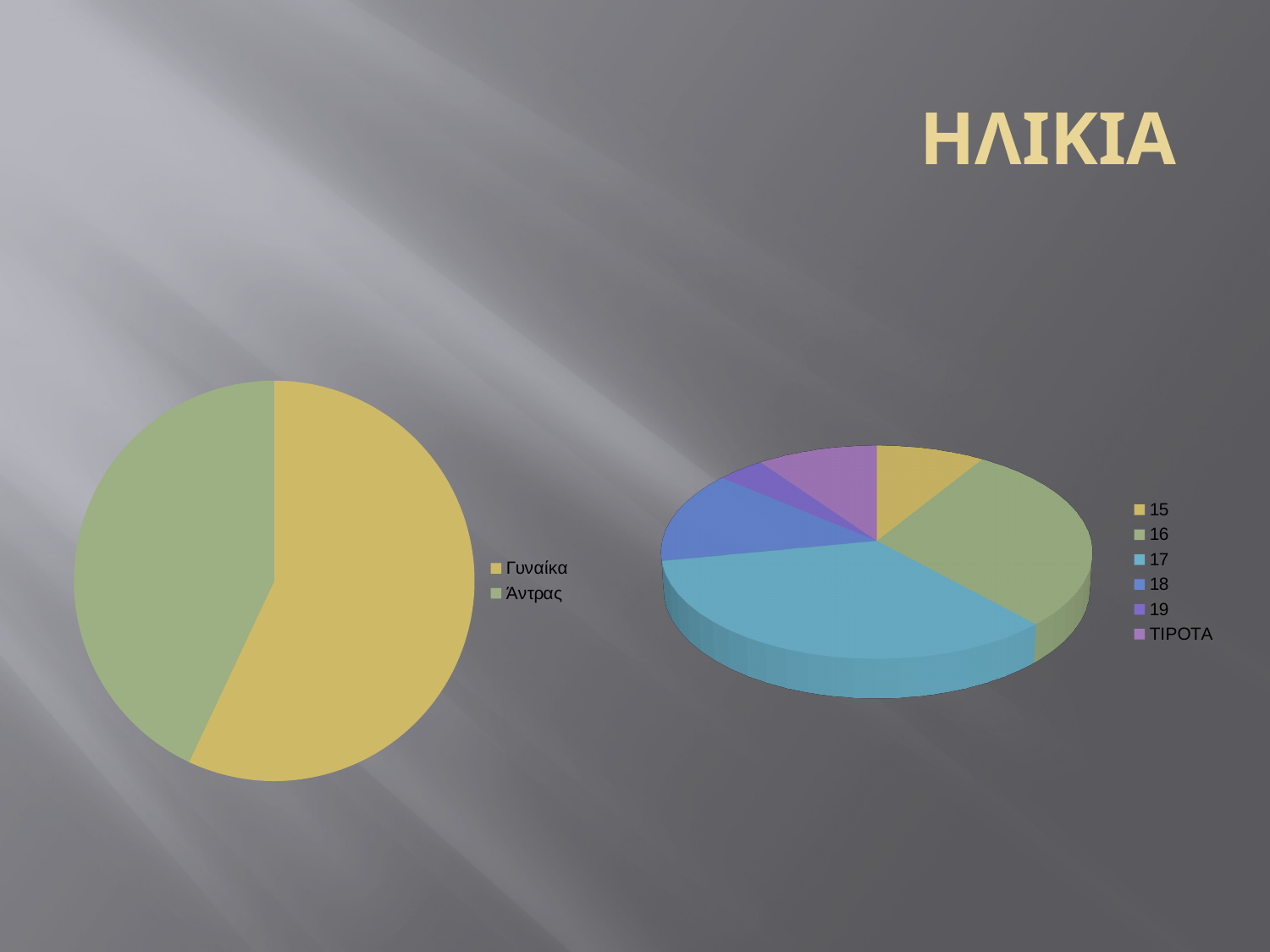
In the right pie chart, which category has the largest slice? 17 In the right pie chart, which category has the smallest slice? 19 In the left pie chart, which category has the larger slice? Γυναίκα In the right pie chart, what is the last entry listed in the legend? TIPOTA What kind of chart is the chart on the right of the slide? pie chart What is the title shown on the slide? ΗΛΙΚΙΑ In the left pie chart, how many categories does the legend list? 2 What kind of chart is the chart on the left of the slide? pie chart In the right pie chart, which slice is larger, 17 or 15? 17 In the right pie chart, which slice is larger, 16 or 18? 16 In the left pie chart, which category has the smaller slice? Άντρας In the right pie chart, how many categories does the legend list? 6